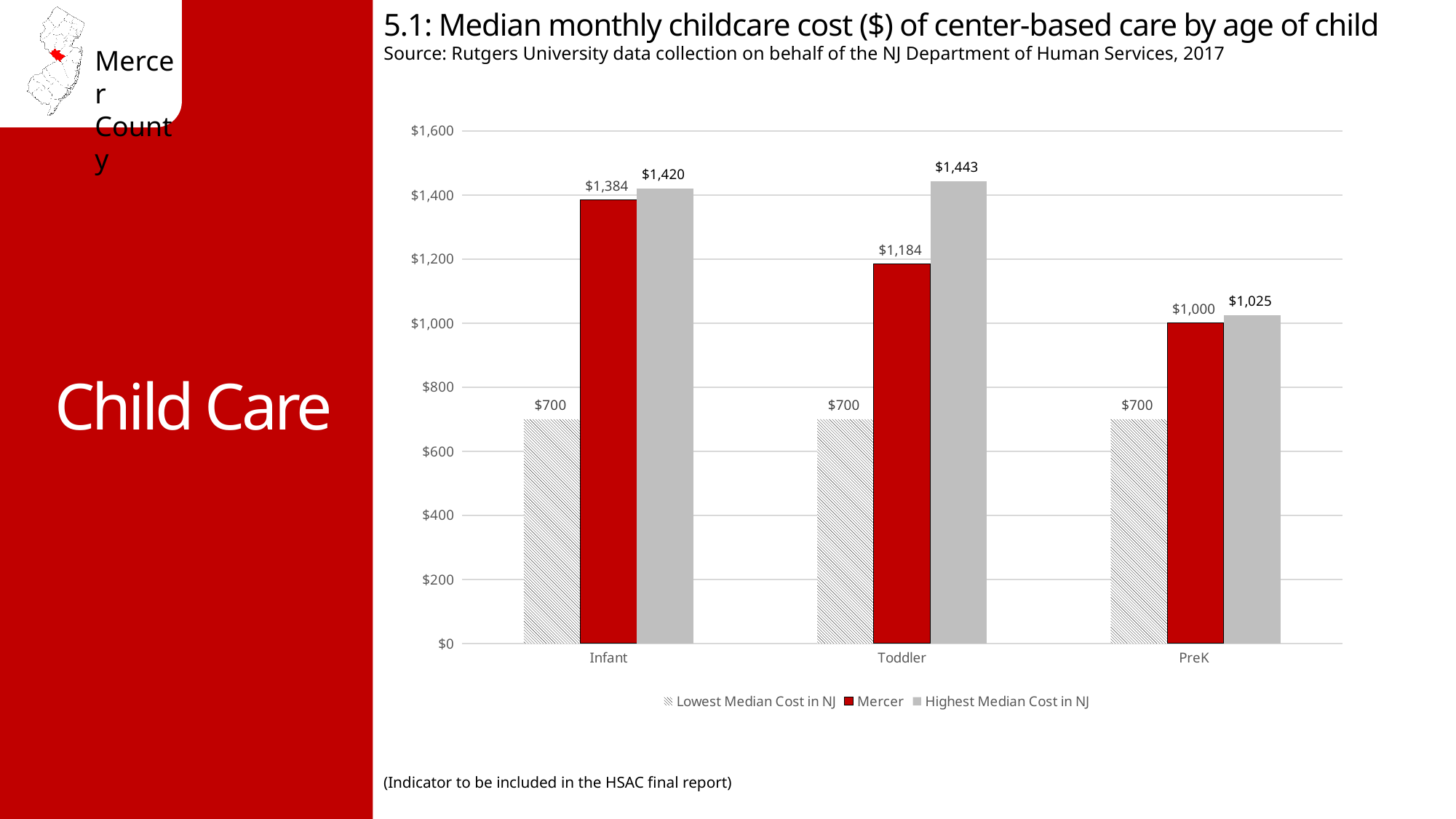
Which series is drawn in red? Mercer What is the difference between the Highest Median Cost in NJ and the Mercer cost for Toddler care? $259 How many series does the legend list? 3 For which age group is the Mercer median monthly cost highest? Infant What kind of chart is shown on the slide? bar chart Is the Mercer value for Toddler care greater or less than $1,200? less What is the Highest Median Cost in NJ for Toddler care? $1,443 What is the median monthly childcare cost for Mercer for Infant care? $1,384 How many age groups are shown on the x axis? 3 Which is larger for PreK care: the Mercer cost or the Highest Median Cost in NJ? Highest Median Cost in NJ For which age group is the Highest Median Cost in NJ lowest? PreK What is the Lowest Median Cost in NJ for PreK care? $700